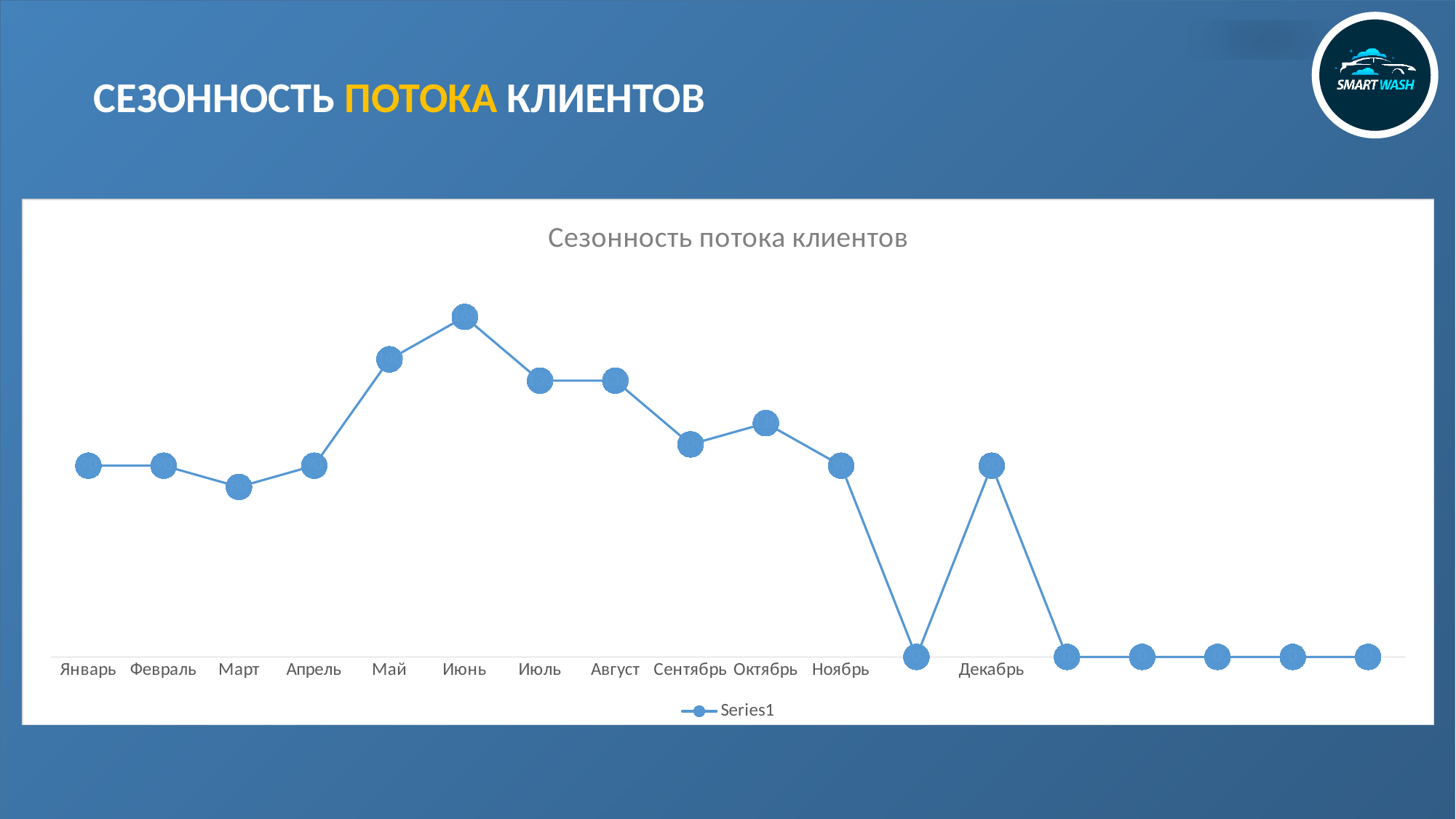
What is the title of the chart? Сезонность потока клиентов Do the values rise or fall from Июнь to Сентябрь? Fall What kind of chart is shown on the slide? Line chart How many month labels are shown on the x axis? 12 Which is larger, the value for Сентябрь or the value for Октябрь? Октябрь Which is larger, the value for Май or the value for Июль? Май Which month has the highest value in the chart? Июнь How many data points are plotted on the line? 18 What is the name of the series shown in the legend? Series1 Do the values rise or fall from Апрель to Июнь? Rise How many series does the legend list? 1 Which is larger, the value for Март or the value for Апрель? Апрель